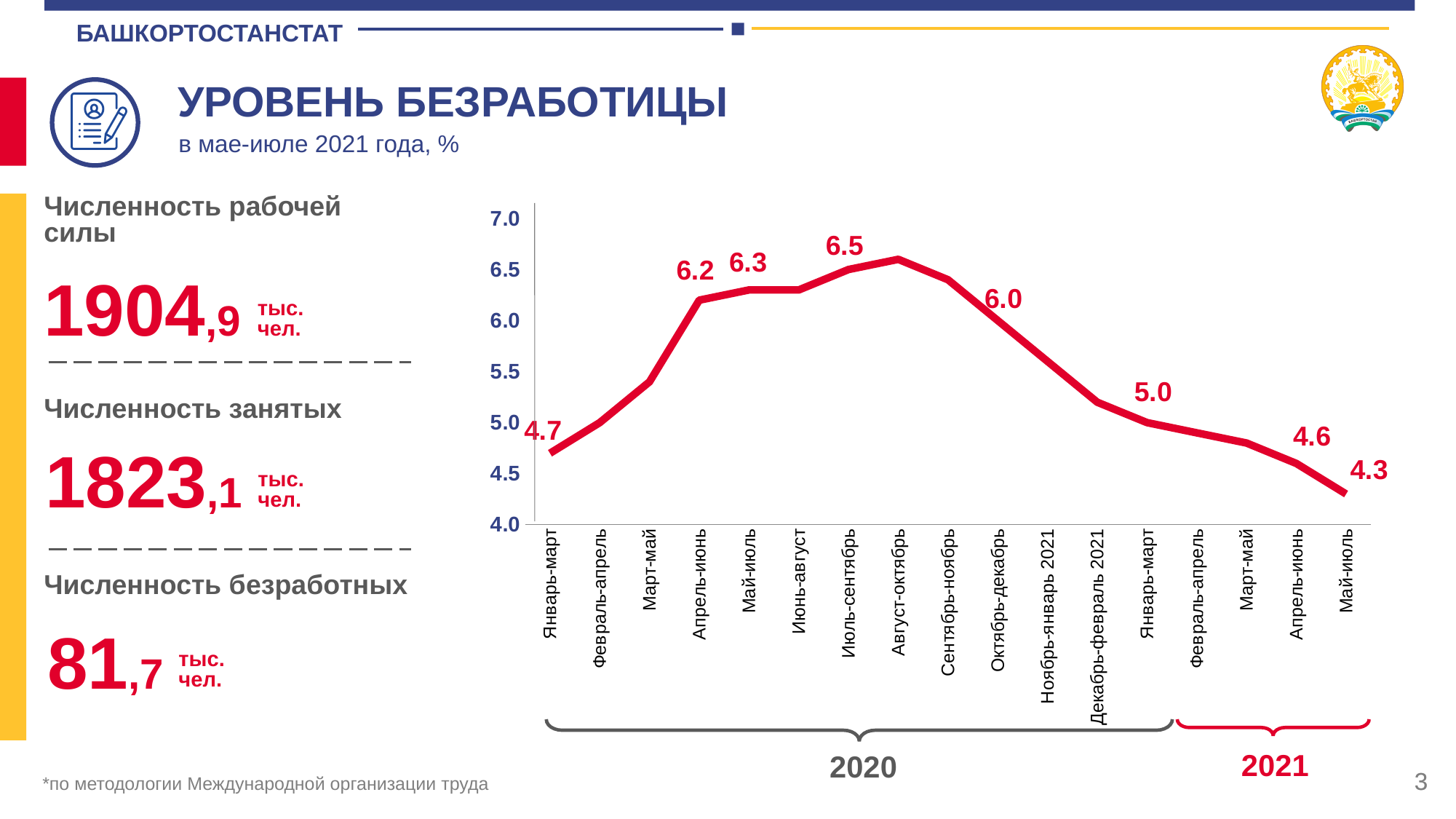
Does the unemployment rate rise or fall from Август-октябрь to Май-июль 2021? fall Is the value for Сентябрь-ноябрь greater or less than 6.0? greater What is the unemployment rate for Май-июль 2020? 6.3 What is the difference between the unemployment rate for Май-июль 2020 and Январь-март 2020? 1.6 What is the unemployment rate for Январь-март 2020? 4.7 What is the unemployment rate for Май-июль 2021? 4.3 How many periods are plotted on the x axis? 17 What kind of chart is shown on the slide? line chart What is the unemployment rate for Апрель-июнь 2020? 6.2 Which period has the highest unemployment rate? Август-октябрь Which period has the lowest unemployment rate? Май-июль 2021 Which is larger, the unemployment rate for Май-июль 2020 or Май-июль 2021? Май-июль 2020